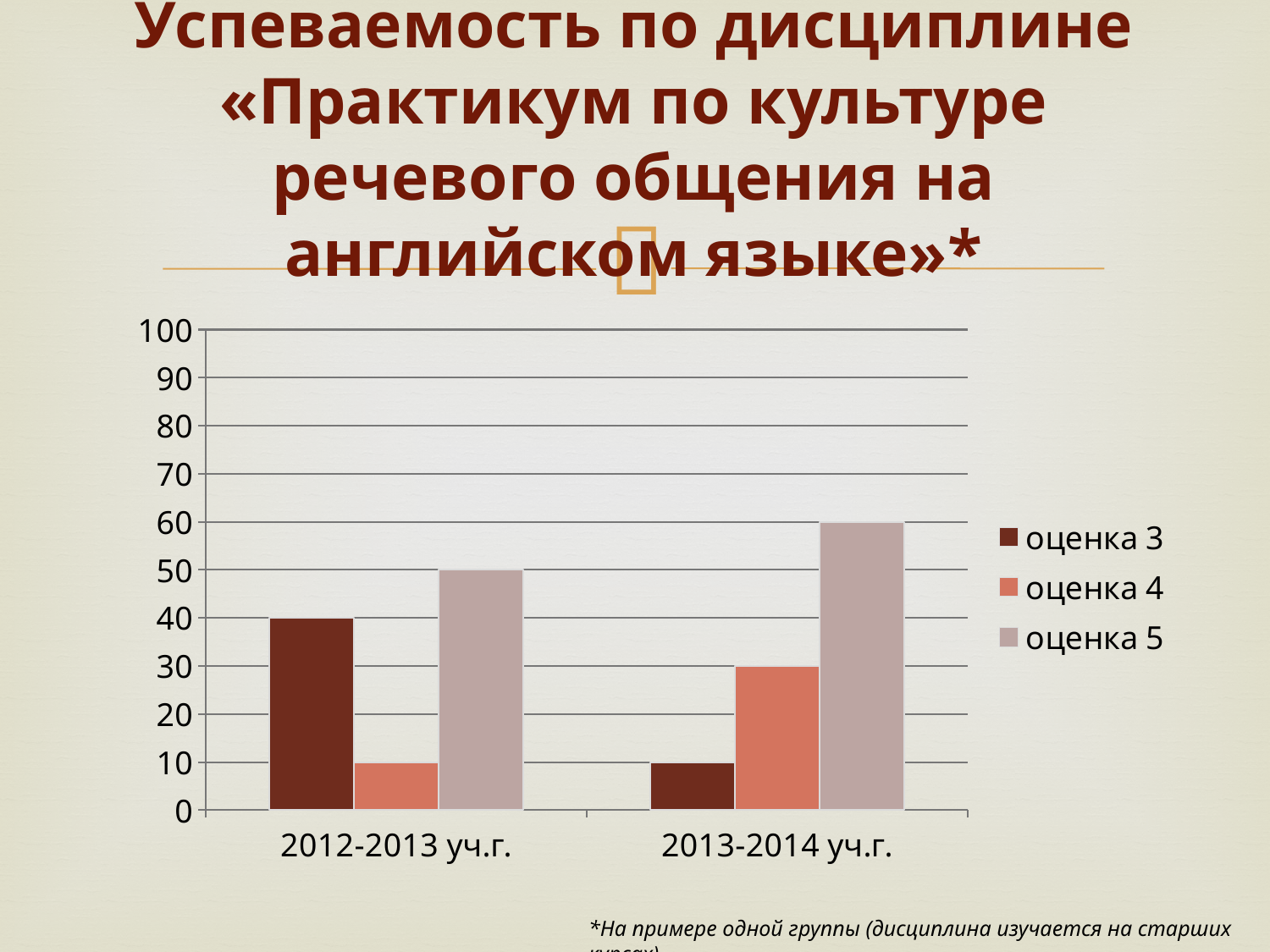
Which is larger: оценка 3 in 2012-2013 уч.г. or оценка 3 in 2013-2014 уч.г.? 2012-2013 уч.г. Does the value for оценка 5 rise or fall from 2012-2013 уч.г. to 2013-2014 уч.г.? rise What kind of chart is shown on the slide? bar chart Which series has the lowest value in 2013-2014 уч.г.? оценка 3 How many series does the legend list? 3 What is the value for оценка 5 in 2013-2014 уч.г.? 60 How many categories are shown on the x axis? 2 Which series has the highest value in 2012-2013 уч.г.? оценка 5 What is the value for оценка 4 in 2013-2014 уч.г.? 30 What is the difference between оценка 5 and оценка 4 in 2012-2013 уч.г.? 40 Which legend entry is shown in the darkest colour? оценка 3 What is the value for оценка 3 in 2012-2013 уч.г.? 40